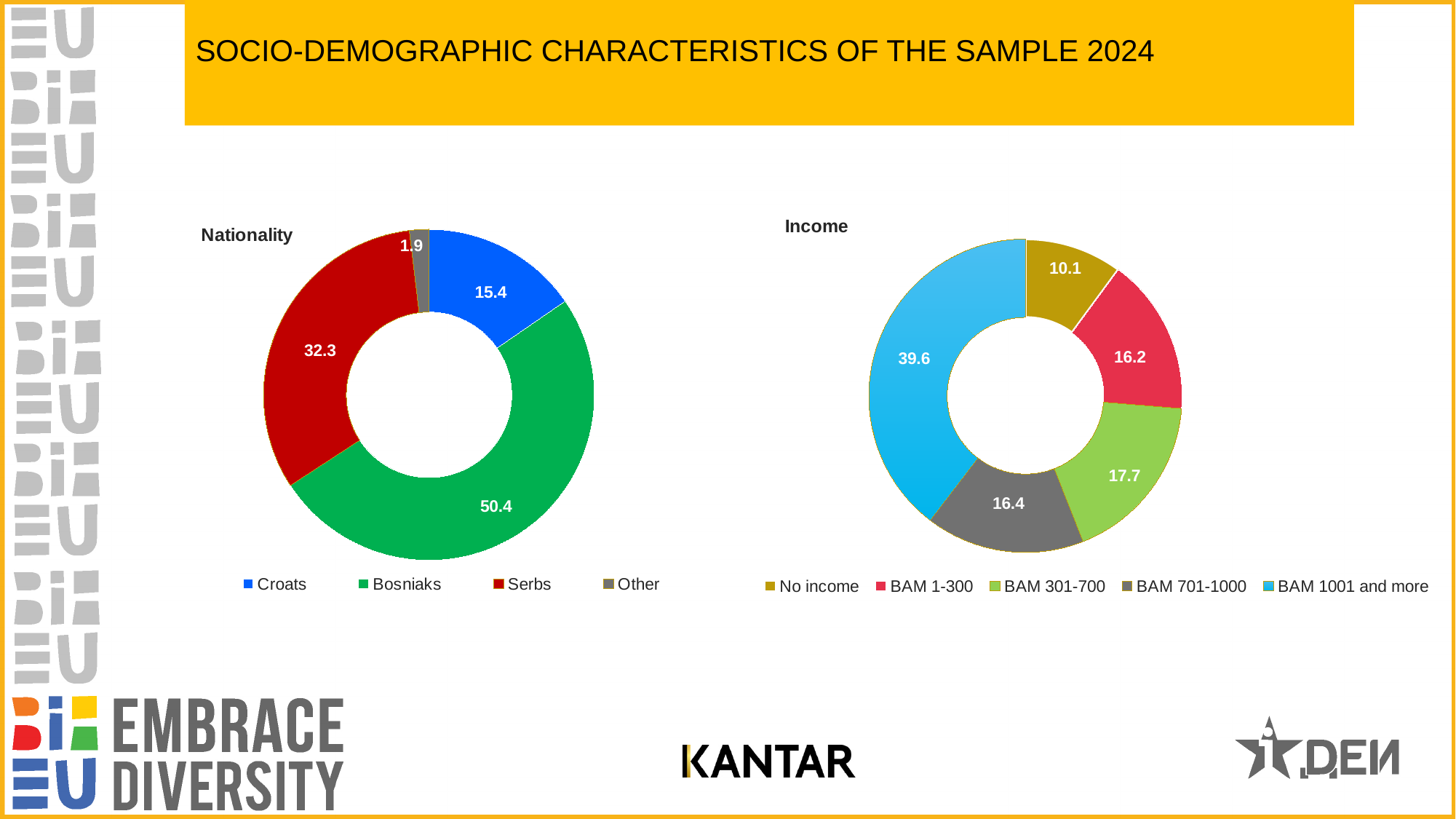
In the Income chart, what is the value for No income? 10.1 In the Income chart, what is the value for BAM 1001 and more? 39.6 In the Income chart, which is larger, BAM 301-700 or BAM 701-1000? BAM 301-700 In the Nationality chart, what is the value for Bosniaks? 50.4 In the Income chart, which category has the largest share? BAM 1001 and more In the Income chart, how many categories does the legend list? 5 What type of chart is the Income chart? Doughnut chart In the Nationality chart, what is the value for Serbs? 32.3 In the Income chart, what is the difference between the values for BAM 1001 and more and No income? 29.5 In the Nationality chart, which category has the smallest share? Other In the Nationality chart, how many categories are shown? 4 In the Nationality chart, what is the difference between the values for Serbs and Croats? 16.9